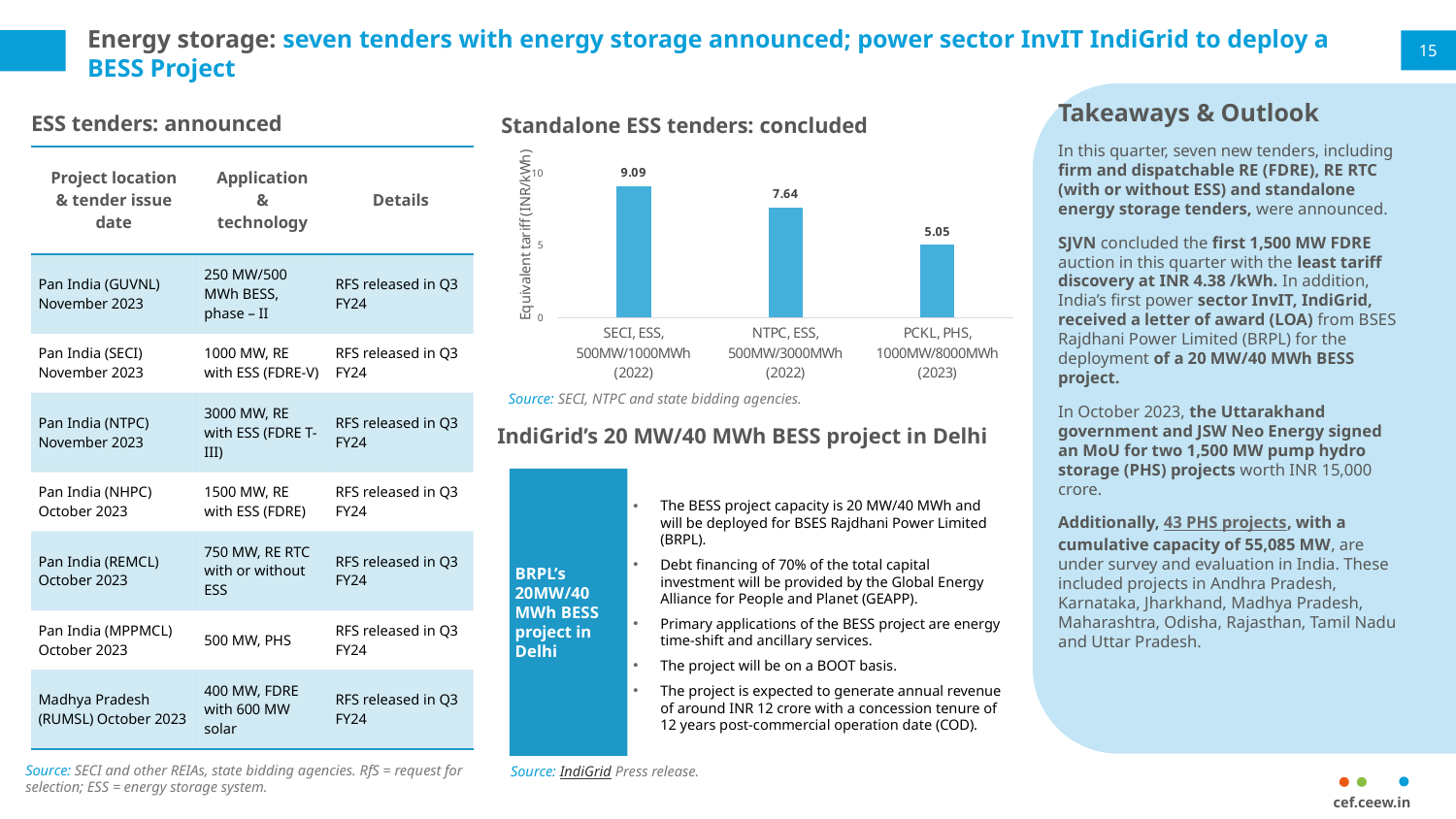
What type of chart is used to show the standalone ESS tenders concluded? Bar chart What is the label of the y-axis in the chart? Equivalent tariff (INR/kWh) What is the equivalent tariff for the SECI, ESS, 500MW/1000MWh (2022) tender? 9.09 Is the equivalent tariff for the PCKL, PHS tender greater or less than 5? greater Which tender has the highest equivalent tariff in the chart? SECI, ESS, 500MW/1000MWh (2022) Which has a higher equivalent tariff, the NTPC ESS tender or the PCKL PHS tender? NTPC, ESS, 500MW/3000MWh (2022) How many tenders are plotted in the chart? 3 What is the equivalent tariff for the PCKL, PHS, 1000MW/8000MWh (2023) tender? 5.05 What is the equivalent tariff for the NTPC, ESS, 500MW/3000MWh (2022) tender? 7.64 What is the difference in equivalent tariff between the NTPC tender and the PCKL tender? 2.59 What is the difference in equivalent tariff between the SECI tender and the NTPC tender? 1.45 Which tender has the lowest equivalent tariff in the chart? PCKL, PHS, 1000MW/8000MWh (2023)